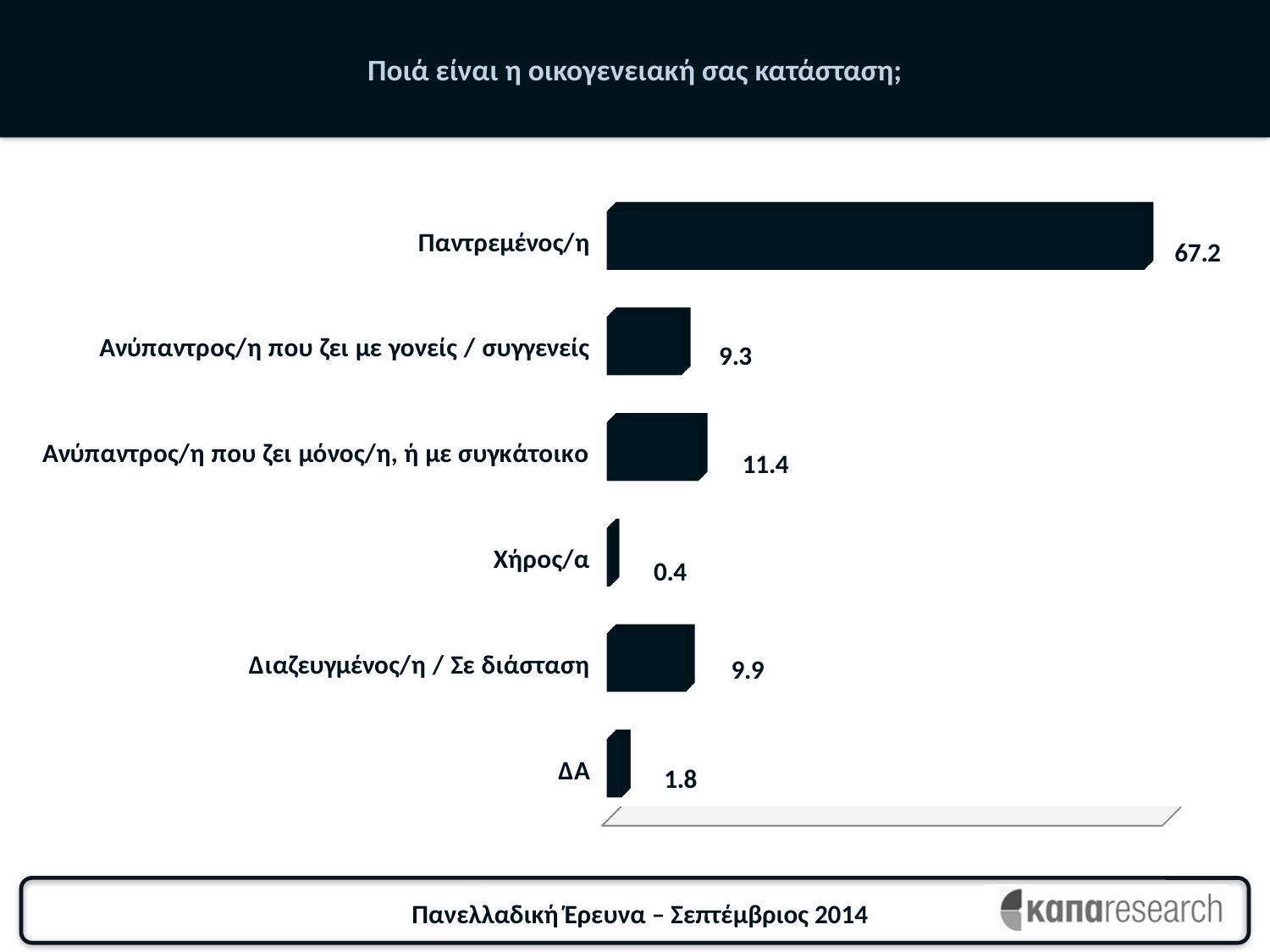
What is the difference between the values for Παντρεμένος/η and Ανύπαντρος/η που ζει μόνος/η, ή με συγκάτοικο? 55.8 Which is larger, the value for Διαζευγμένος/η / Σε διάσταση or the value for Ανύπαντρος/η που ζει με γονείς / συγγενείς? Διαζευγμένος/η / Σε διάσταση Which category has the lowest value? Χήρος/α What is the value for Ανύπαντρος/η που ζει μόνος/η, ή με συγκάτοικο? 11.4 What is the value for Διαζευγμένος/η / Σε διάσταση? 9.9 What kind of chart is shown on the slide? Bar chart What is the value for Παντρεμένος/η? 67.2 How many categories are shown in the chart? 6 Which category has the highest value? Παντρεμένος/η What is the value for Ανύπαντρος/η που ζει με γονείς / συγγενείς? 9.3 What is the value for ΔΑ? 1.8 What is the value for Χήρος/α? 0.4